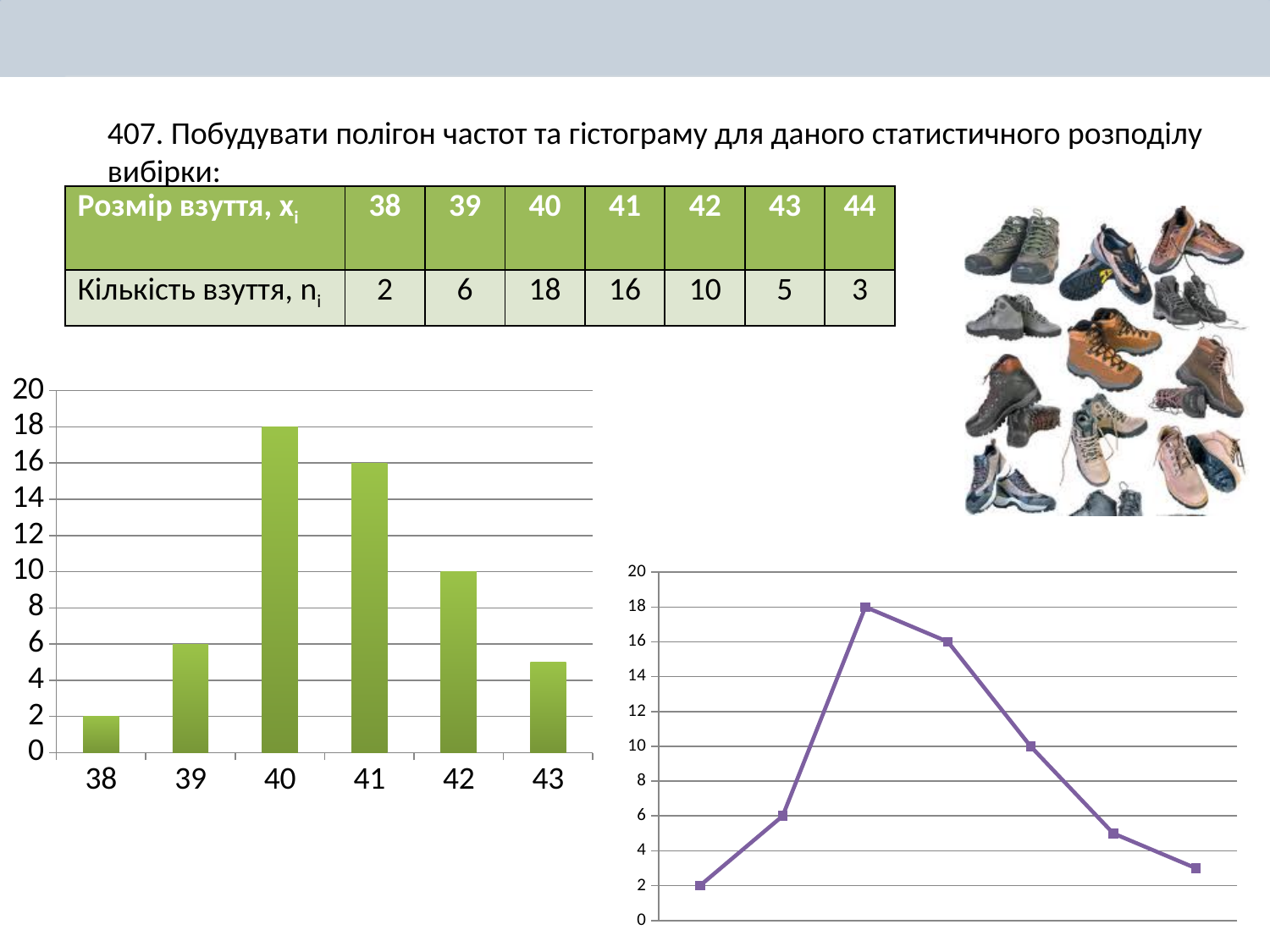
How many data points are plotted in the line chart on the lower right? 7 In the bar chart on the left, what is the value for 38? 2 In the bar chart on the left, which category has the lowest bar? 38 In the bar chart on the left, which category has the highest bar? 40 In the bar chart on the left, what is the value for 42? 10 In the bar chart on the left, which is larger, the value for 39 or the value for 42? 42 What kind of chart is the chart on the lower right? line chart In the bar chart on the left, what is the value for 40? 18 In the bar chart on the left, is the value for 43 greater or less than 4? greater In the bar chart on the left, what is the difference between the values for 40 and 41? 2 How many categories are shown on the x axis of the bar chart on the left? 6 What kind of chart is the chart on the left? bar chart